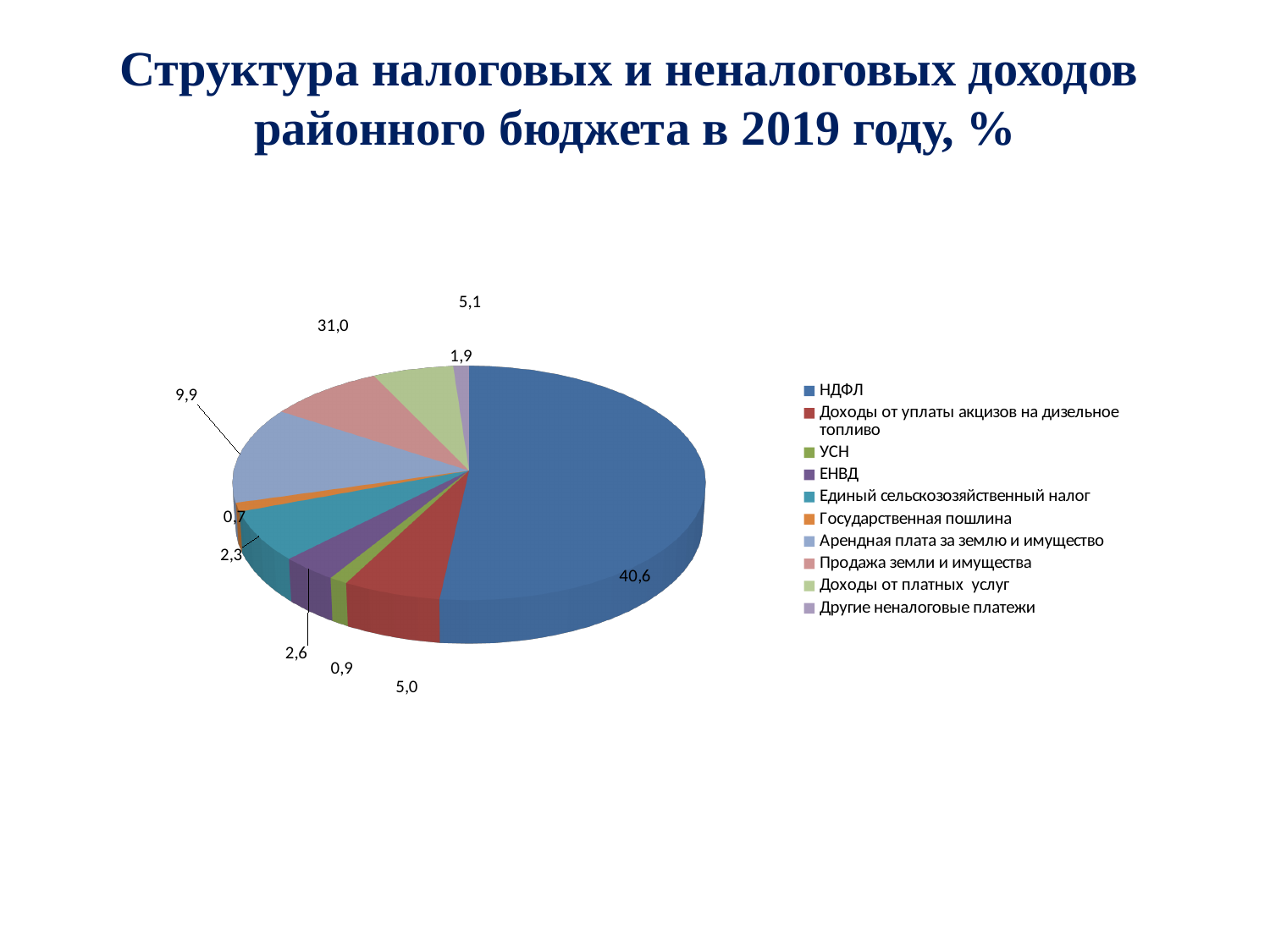
What is the value shown for НДФЛ? 40,6 Which category has the largest share of the pie? НДФЛ What is the difference between the values for НДФЛ and Доходы от уплаты акцизов на дизельное топливо? 35,6 What is the value shown for ЕНВД? 2,6 What is the value shown for Арендная плата за землю и имущество? 9,9 How many categories does the legend of the pie chart list? 10 What is the value shown for Доходы от уплаты акцизов на дизельное топливо? 5,0 What year does the chart title say the data refers to? 2019 What is the value shown for Государственная пошлина? 0,7 What kind of chart is shown on the slide? pie chart Which category has the smallest share of the pie? Государственная пошлина Which is larger, the value for ЕНВД or the value for Единый сельскохозяйственный налог? ЕНВД